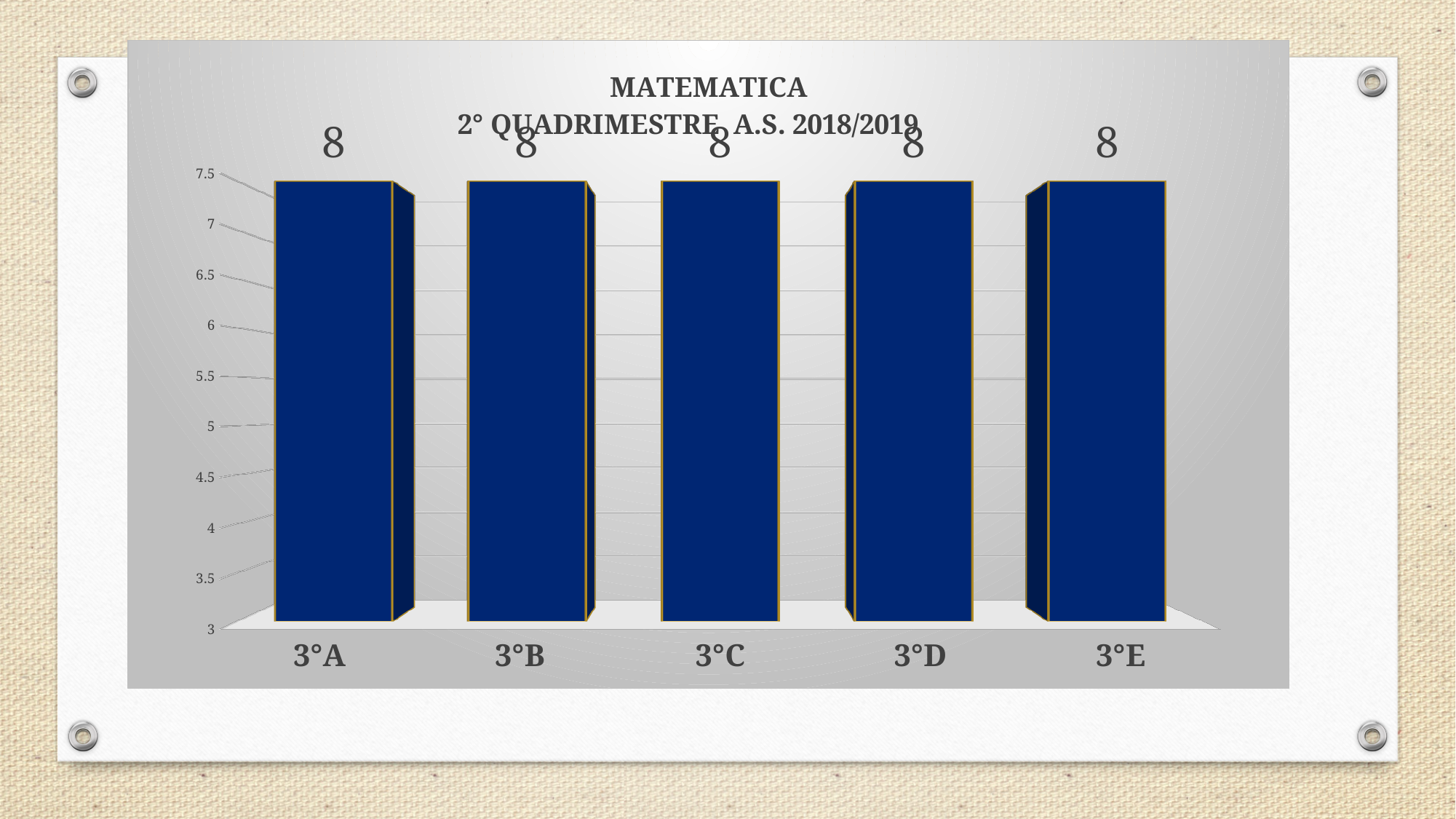
What is the value for 3°A? 8 What is the title of the chart? MATEMATICA 2° QUADRIMESTRE A.S. 2018/2019 What colour are the bars in the chart? dark blue What is the value for 3°C? 8 Do the values rise, fall, or stay flat from 3°A to 3°E? stay flat Is the value for 3°B larger than, smaller than, or equal to the value for 3°E? equal What is the value for 3°E? 8 What kind of chart is shown on the slide? bar chart What is the value for 3°D? 8 Is the value for 3°C greater or less than 7? greater How many classes are shown on the x axis? 5 What is the difference between the values for 3°B and 3°D? 0